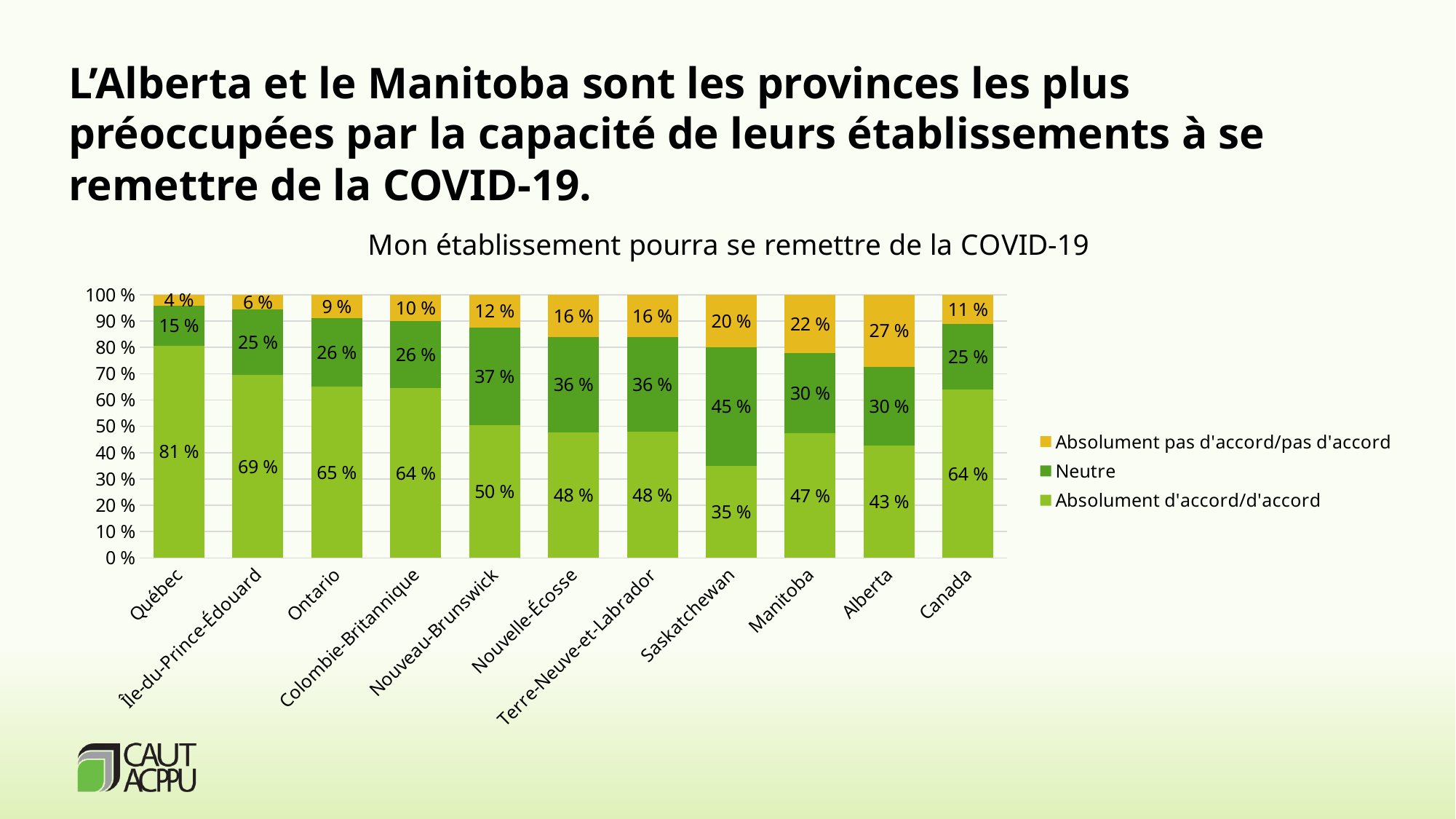
How many series does the legend list? 3 What is the difference between the 'Absolument d'accord/d'accord' values for Québec and Alberta? 38 % What kind of chart is shown on the slide? Stacked bar chart What is the 'Neutre' value for Saskatchewan? 45 % What is the title of the chart? Mon établissement pourra se remettre de la COVID-19 Which category has the lowest 'Absolument pas d'accord/pas d'accord' value? Québec How many categories are shown on the x axis? 11 Which province has the highest 'Absolument d'accord/d'accord' value? Québec Which is larger: the 'Neutre' value for Manitoba or for Nouveau-Brunswick? Nouveau-Brunswick What is the value for Québec in the 'Absolument d'accord/d'accord' series? 81 % What is the total of the stacked bar for Canada? 100 % What is the value for Alberta in the 'Absolument pas d'accord/pas d'accord' series? 27 %